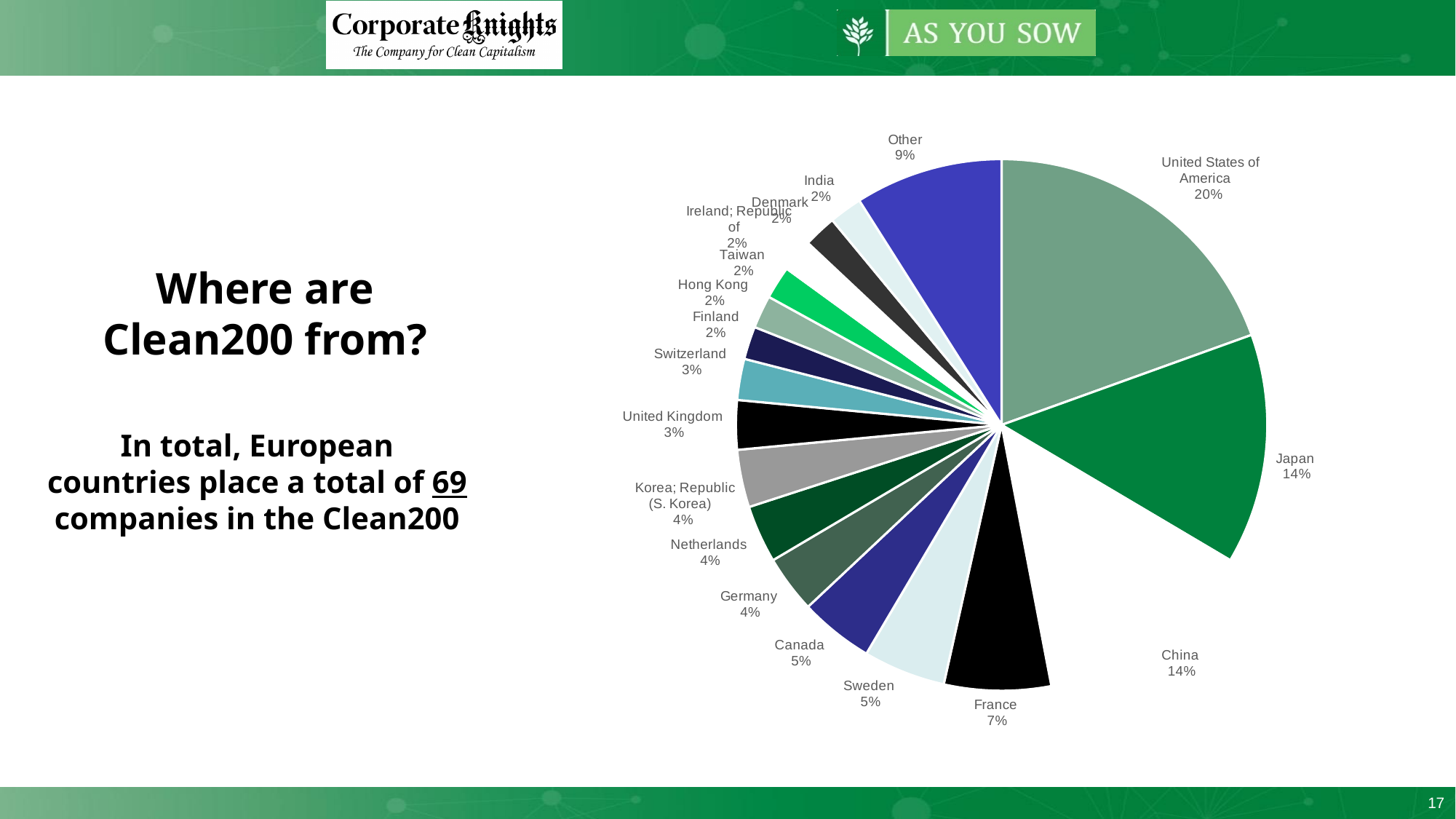
What kind of chart is shown on the slide? pie chart What is the title text to the left of the chart asking? Where are Clean200 from? What percentage is shown for France? 7% What percentage is shown for the Netherlands? 4% Which is larger, the slice for Japan or the slice for France? Japan Which country has the largest slice of the pie? United States of America What percentage is shown for Switzerland? 3% What percentage is shown for the 'Other' slice? 9% What share of the pie does the United States of America hold? 20% How many slices does the pie chart have? 18 What is the difference in percentage points between the United States of America and Japan? 6 What percentage is shown for Sweden? 5%